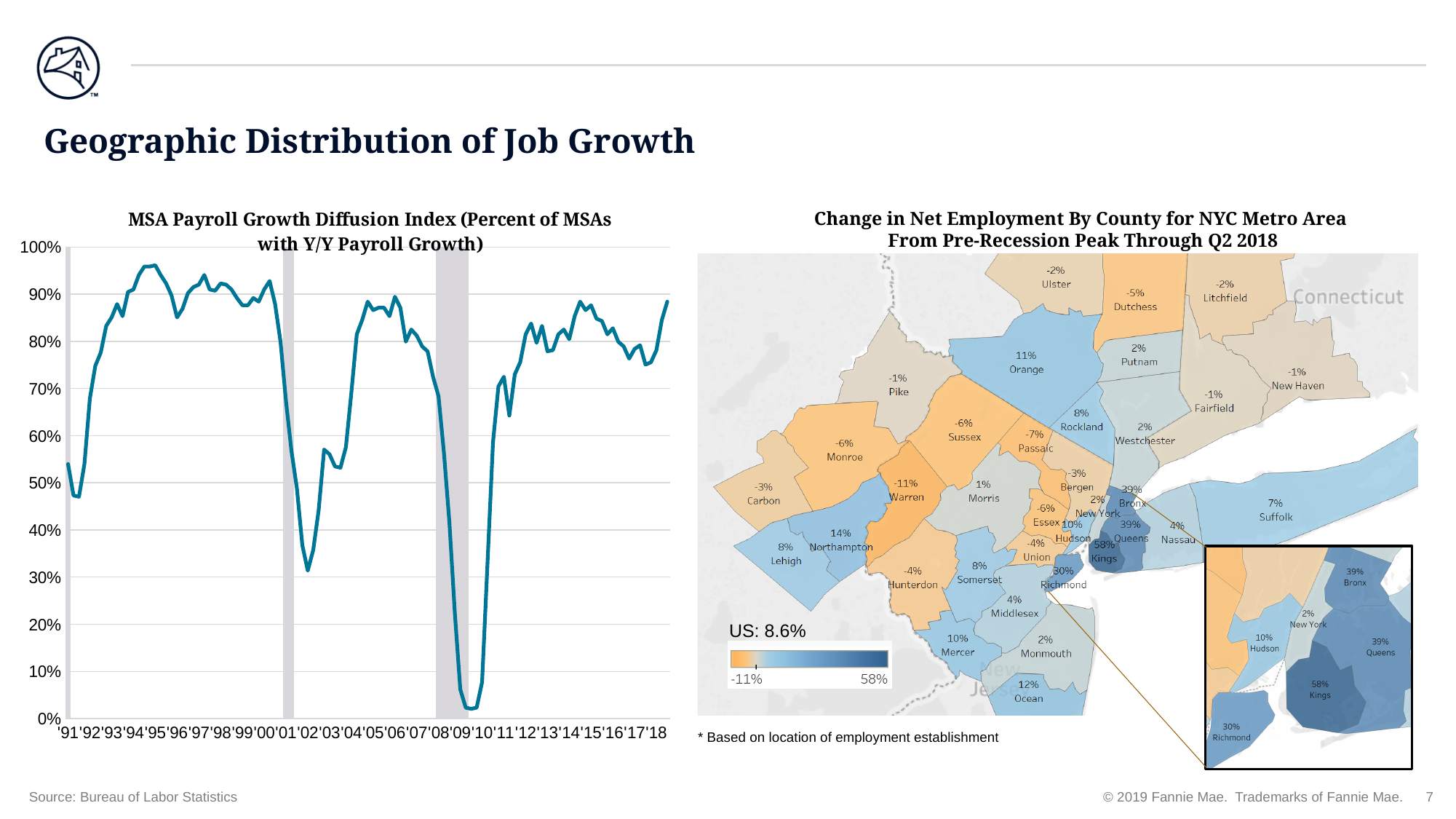
On the map 'Change in Net Employment By County for NYC Metro Area', which has the larger value, Suffolk or Nassau? Suffolk In the 'MSA Payroll Growth Diffusion Index' chart, is the value at the low point around 2002 greater or less than 40%? less On the map 'Change in Net Employment By County for NYC Metro Area', what is the value shown for Richmond? 30% On the map 'Change in Net Employment By County for NYC Metro Area', what is the value shown for Kings county? 58% On the map 'Change in Net Employment By County for NYC Metro Area', which county has the highest value? Kings On the map 'Change in Net Employment By County for NYC Metro Area', what is the value shown for the US overall? 8.6% On the map 'Change in Net Employment By County for NYC Metro Area', what is the difference between the values for Kings and Queens? 19 percentage points On the map 'Change in Net Employment By County for NYC Metro Area', which county has the lowest value? Warren On the map 'Change in Net Employment By County for NYC Metro Area', what is the value shown for Orange county? 11% What kind of chart is the 'MSA Payroll Growth Diffusion Index' chart on the left? line chart In the 'MSA Payroll Growth Diffusion Index' chart, is the value at the low point in 2009 greater or less than 10%? less In the 'MSA Payroll Growth Diffusion Index' chart, is the value at the peak around 1995 greater or less than 90%? greater